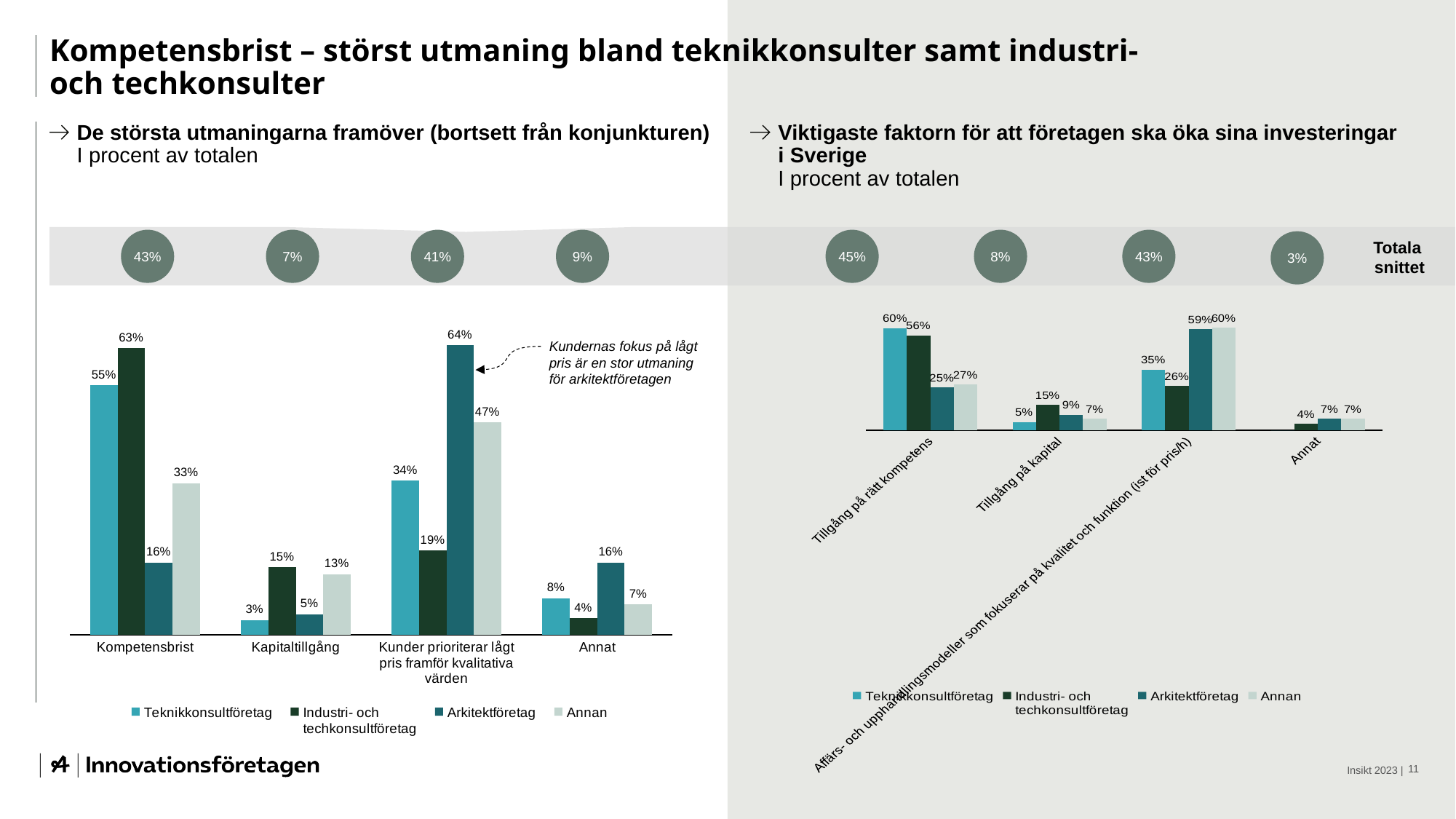
In the right chart (Viktigaste faktorn för att företagen ska öka sina investeringar i Sverige), what is the Totala snittet value shown for Annat? 3% What kind of chart is the left chart (De största utmaningarna framöver)? Bar chart In the left chart (De största utmaningarna framöver), what is the Totala snittet value shown for Kompetensbrist? 43% In the right chart (Viktigaste faktorn för att företagen ska öka sina investeringar i Sverige), what is the value for Teknikkonsultföretag for Tillgång på rätt kompetens? 60% In the left chart (De största utmaningarna framöver), what is the value for Arkitektföretag for Kunder prioriterar lågt pris framför kvalitativa värden? 64% In the left chart (De största utmaningarna framöver), what is the difference between the Teknikkonsultföretag and Arkitektföretag values for Kompetensbrist? 39 percentage points In the right chart (Viktigaste faktorn för att företagen ska öka sina investeringar i Sverige), which series has the highest value for Tillgång på kapital? Industri- och techkonsultföretag In the right chart (Viktigaste faktorn för att företagen ska öka sina investeringar i Sverige), which is larger for Affärs- och upphandlingsmodeller som fokuserar på kvalitet och funktion: Teknikkonsultföretag or Industri- och techkonsultföretag? Teknikkonsultföretag In the left chart (De största utmaningarna framöver), how many series does the legend list? 4 In the left chart (De största utmaningarna framöver), which series has the lowest value for Kapitaltillgång? Teknikkonsultföretag In the left chart (De största utmaningarna framöver), what is the value for Industri- och techkonsultföretag for Kompetensbrist? 63% How many categories are shown on the x axis of the right chart (Viktigaste faktorn för att företagen ska öka sina investeringar i Sverige)? 4